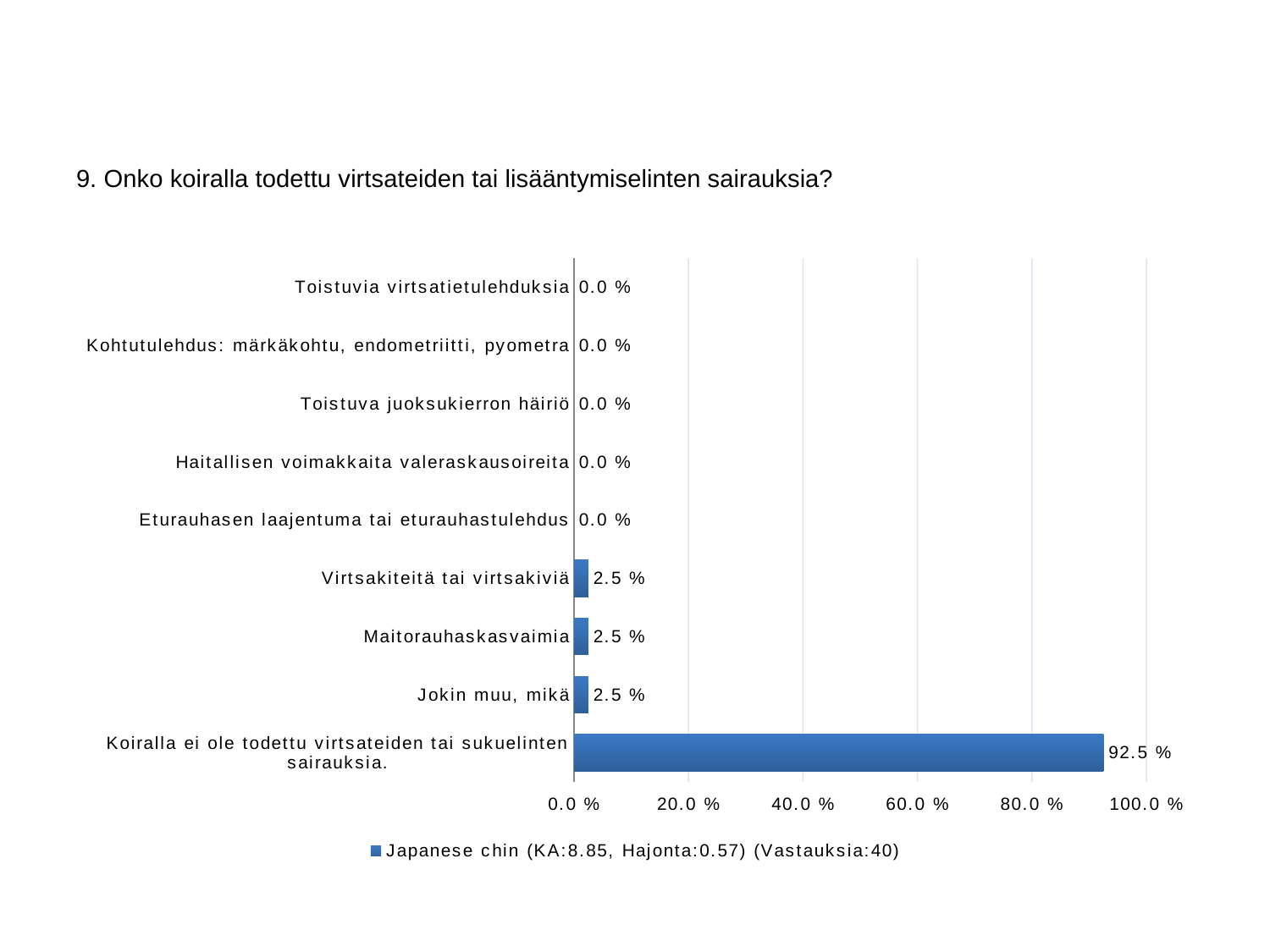
What is the value for "Maitorauhaskasvaimia"? 2.5 % What is the value for "Virtsakiteitä tai virtsakiviä"? 2.5 % What kind of chart is shown on the slide? bar chart How many series does the legend list? 1 What is the value for "Koiralla ei ole todettu virtsateiden tai sukuelinten sairauksia."? 92.5 % What is the value for "Toistuvia virtsatietulehduksia"? 0.0 % Which is larger, the value for "Jokin muu, mikä" or the value for "Eturauhasen laajentuma tai eturauhastulehdus"? Jokin muu, mikä How many categories have a value of 0.0 %? 5 How many categories are shown in the chart? 9 Is the value for "Koiralla ei ole todettu virtsateiden tai sukuelinten sairauksia." greater or less than 80.0 %? greater Which category has the highest value? Koiralla ei ole todettu virtsateiden tai sukuelinten sairauksia. What is the difference between the values for "Koiralla ei ole todettu virtsateiden tai sukuelinten sairauksia." and "Jokin muu, mikä"? 90.0 %